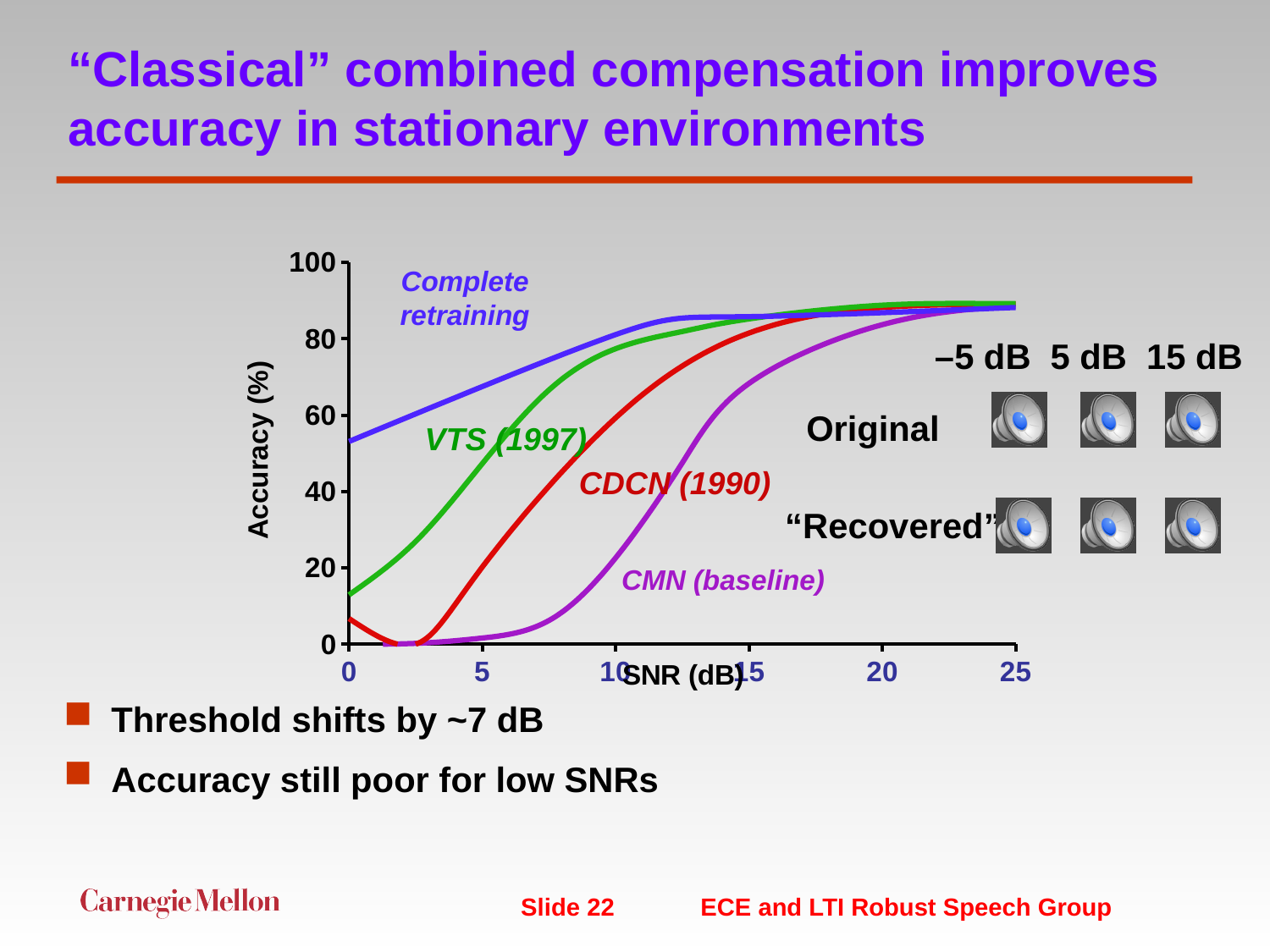
Is the accuracy of the VTS (1997) curve at 0 dB SNR greater or less than 20? less Is the accuracy of the CMN (baseline) curve at 10 dB SNR greater or less than 40? less Which curve has the highest accuracy at an SNR of 0 dB? Complete retraining Is the accuracy of the Complete retraining curve at 0 dB SNR greater or less than 40? greater What is the label of the y axis of the chart? Accuracy (%) Which curve has the lowest accuracy at an SNR of 10 dB? CMN (baseline) What kind of chart is shown on the slide? line chart At an SNR of 10 dB, which curve has higher accuracy, VTS (1997) or CMN (baseline)? VTS (1997) What is the label of the x axis of the chart? SNR (dB) How many curves (series) are plotted on the chart? 4 Does accuracy rise or fall as SNR increases along the x axis? rise